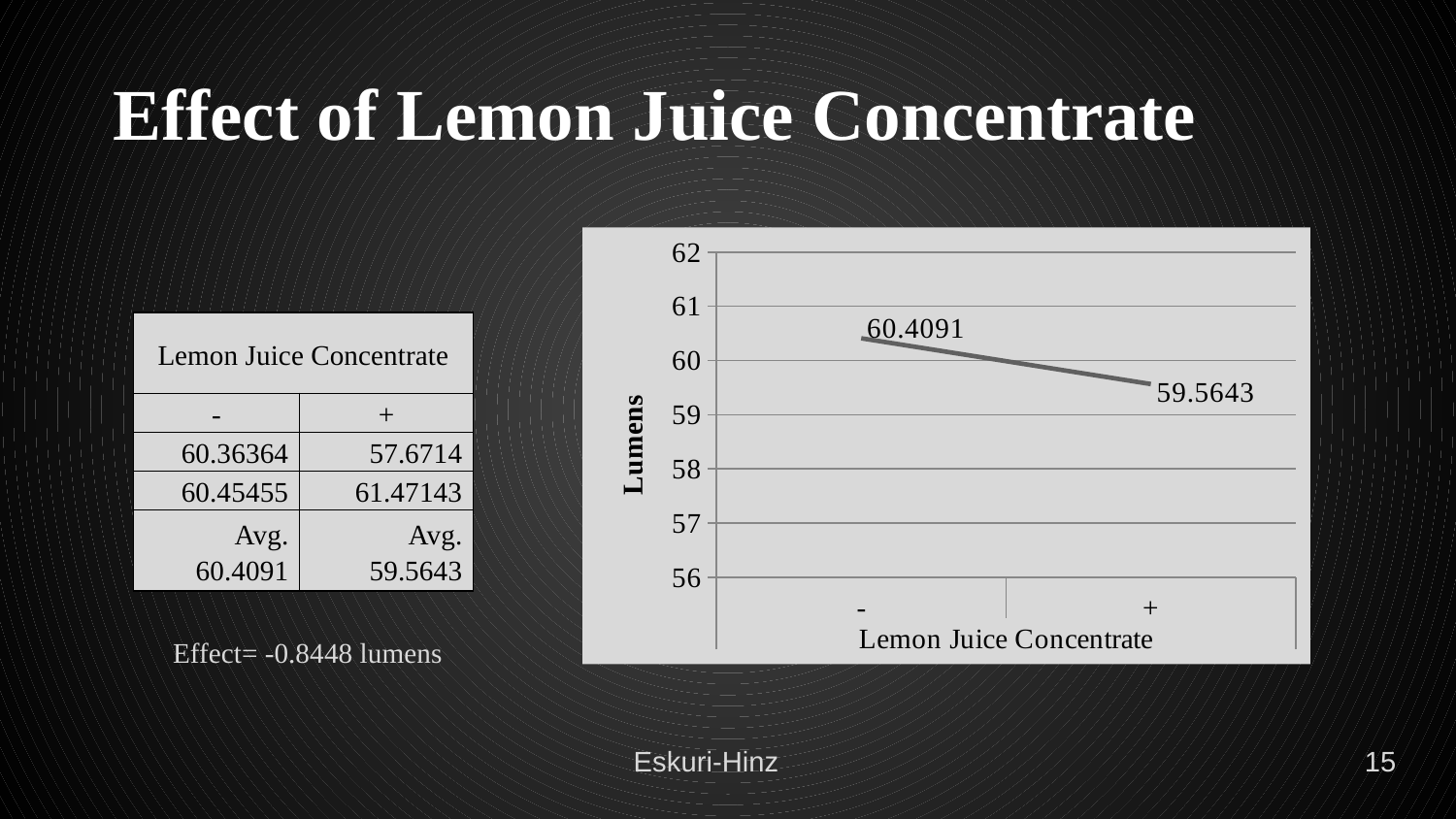
Is the value for the "+" level greater or less than 60? less Which level of Lemon Juice Concentrate has the higher Lumens value? - What is the value for the "-" level of Lemon Juice Concentrate? 60.4091 Is the Lumens value at the "-" level greater or less than the value at the "+" level? greater How many data points are plotted on the chart? 2 Which level of Lemon Juice Concentrate has the lower Lumens value? + What is the difference between the Lumens values at the "-" and "+" levels? 0.8448 Is the value for the "-" level greater or less than 60? greater What is the label of the vertical axis of the chart? Lumens What is the value for the "+" level of Lemon Juice Concentrate? 59.5643 Do the values rise or fall from the "-" level to the "+" level? fall What kind of chart is shown on the slide? line chart